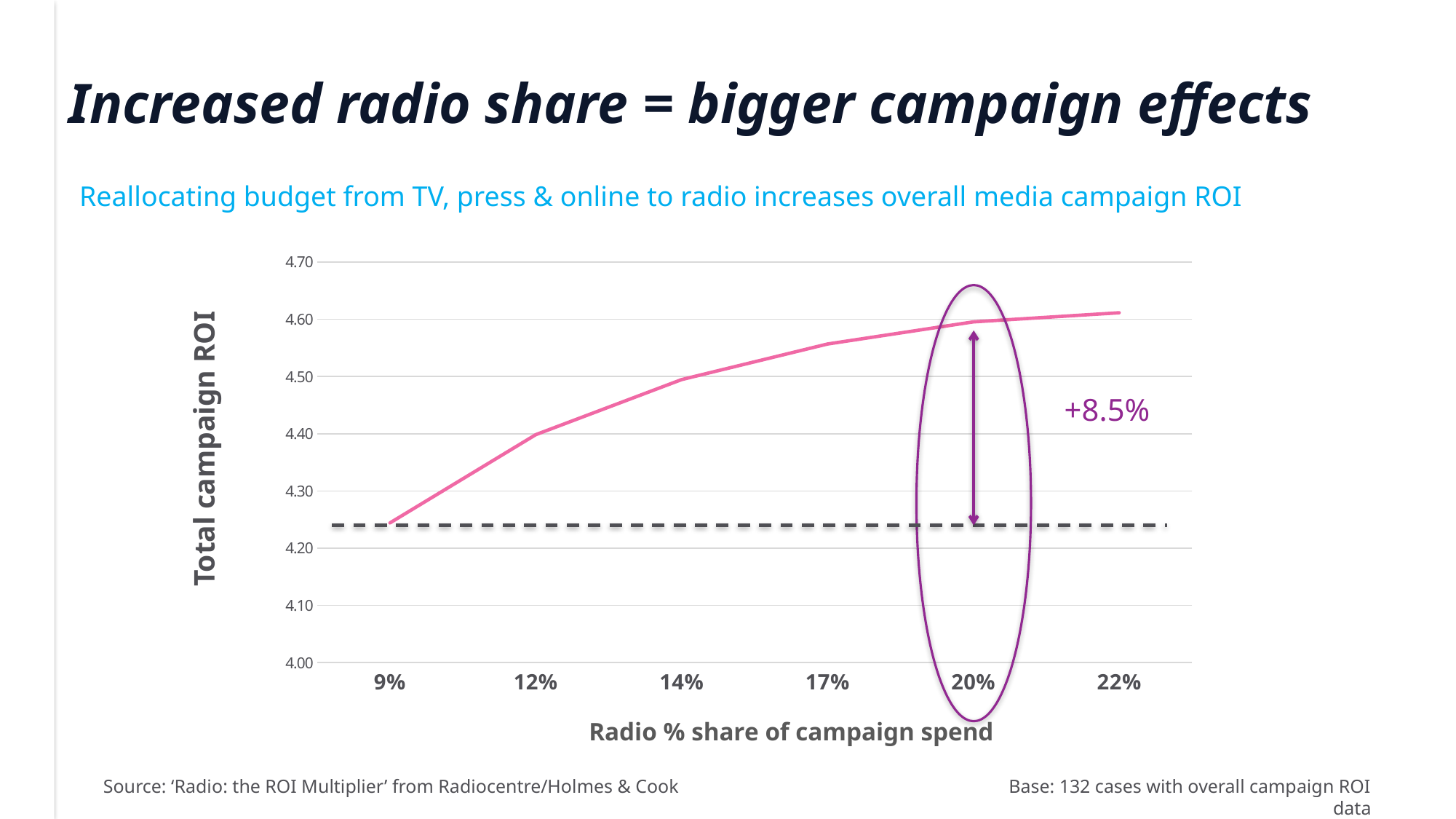
Is the total campaign ROI at a 14% radio share greater or less than 4.40? greater Is the total campaign ROI at a 22% radio share greater or less than 4.50? greater How many radio share categories are shown on the x axis? 6 Is the total campaign ROI at a 9% radio share greater or less than 4.30? less Which has a higher total campaign ROI, a 12% or a 17% radio share? 17% What percentage increase is annotated next to the 20% radio share point? +8.5% Which radio share category has the lowest total campaign ROI? 9% Which radio share category has the highest total campaign ROI? 22% Does total campaign ROI rise or fall as radio % share of campaign spend increases? rise What kind of chart is shown on the slide? line chart What is the title of the y axis? Total campaign ROI